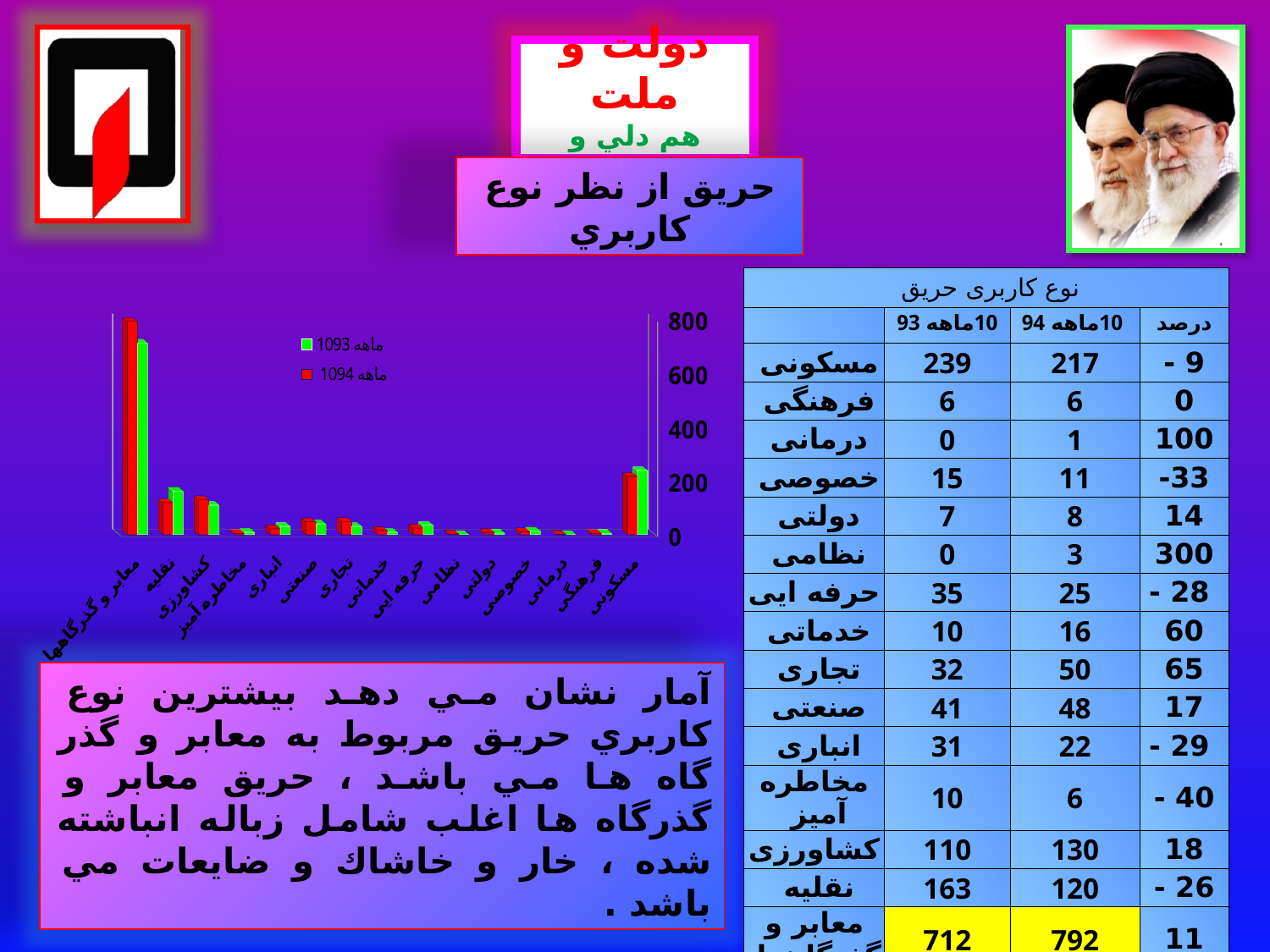
Is the value for کشاورزی in the 1093 ماهه series greater or less than 200? less How many categories are shown along the x axis of the chart? 15 Which category has the highest bars in the chart? معابر و گذرگاهها Is the value for معابر و گذرگاهها in the 1093 ماهه series greater or less than 600? greater Which colour represents the 1094 ماهه series in the chart? red In the 1094 ماهه series, which is larger: معابر و گذرگاهها or مسکونی? معابر و گذرگاهها What kind of chart is shown on the slide? bar chart Is the value for مسکونی in the 1093 ماهه series greater or less than 400? less What is the highest tick value shown on the chart's vertical axis? 800 How many series does the chart legend list? 2